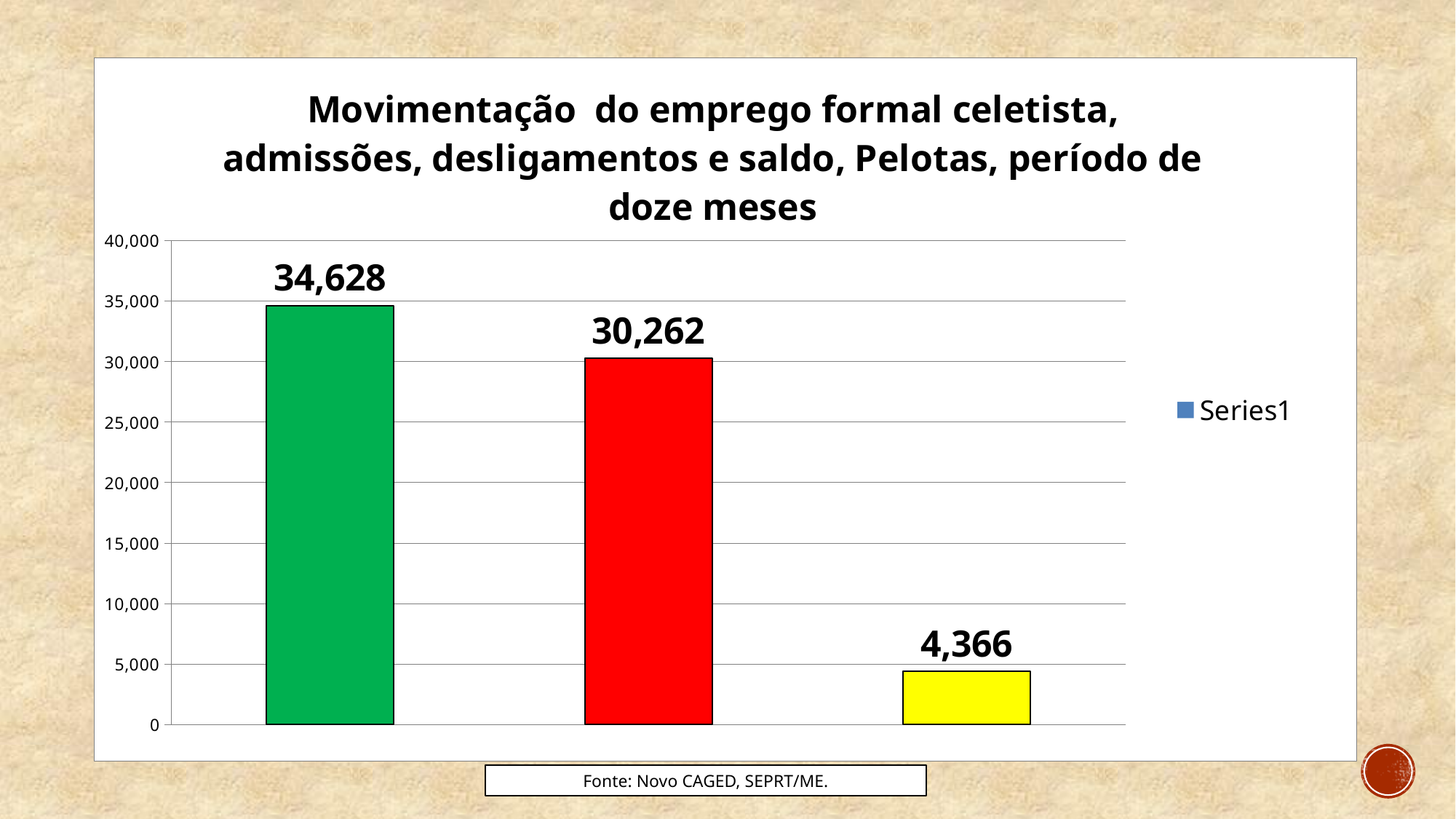
How many bars are plotted in the chart? 3 How many series does the legend list? 1 What is the value shown on the yellow bar (the rightmost bar)? 4,366 Which bar has the lowest value? The yellow bar (rightmost), 4,366 What is the value shown on the green bar (the first bar from the left)? 34,628 What type of chart is shown on the slide? Bar chart What is the difference between the value of the green bar and the value of the red bar? 4,366 Is the value of the yellow bar greater or less than 5,000? less Which bar has the highest value? The green bar (first from the left), 34,628 What is the value shown on the red bar (the middle bar)? 30,262 What is the difference between the value of the red bar and the value of the yellow bar? 25,896 Which is larger, the value of the green bar or the value of the red bar? The green bar